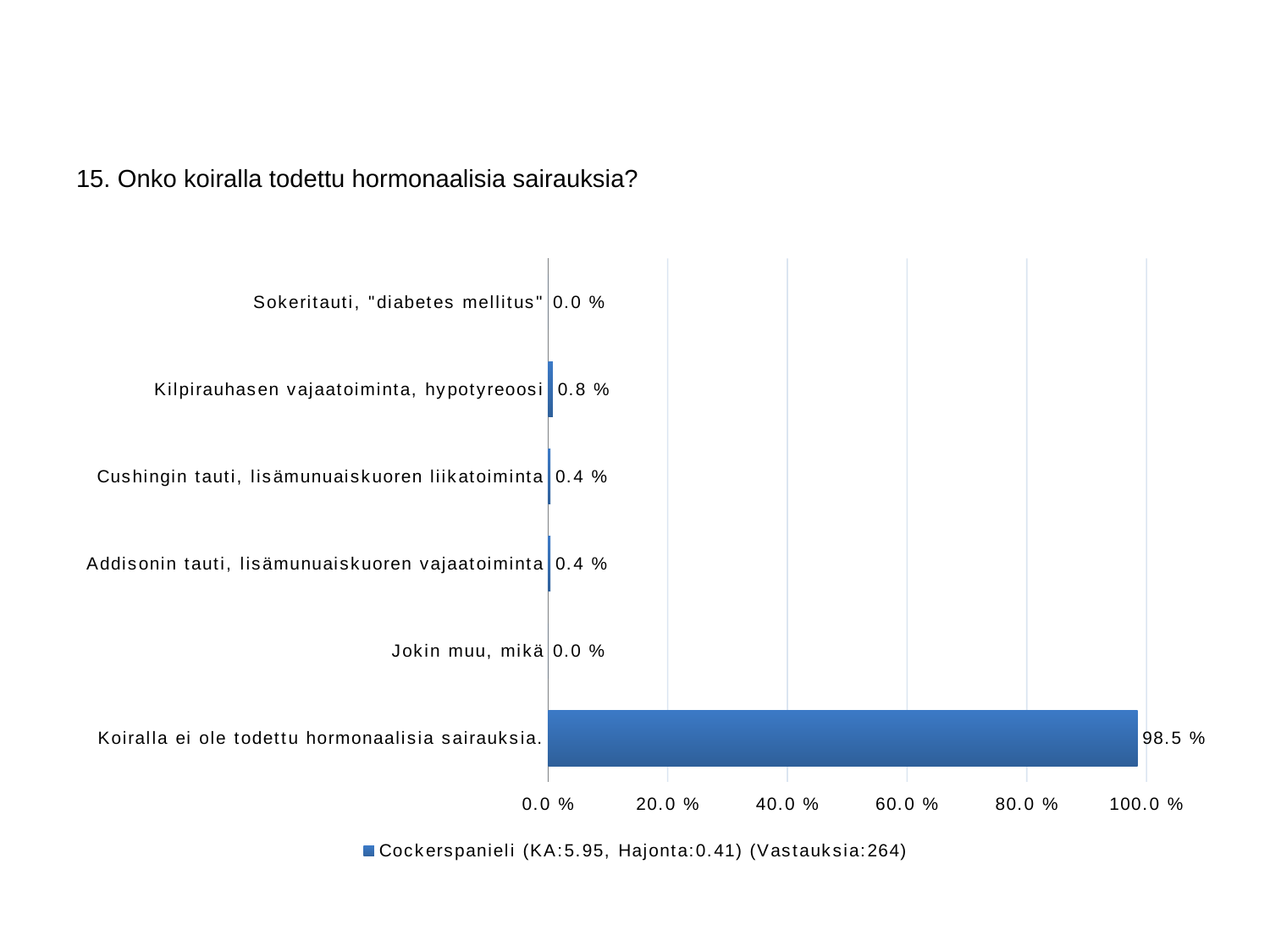
What is the value for "Cushingin tauti, lisämunuaiskuoren liikatoiminta"? 0.4 % Which is larger, the value for "Kilpirauhasen vajaatoiminta, hypotyreoosi" or the value for "Addisonin tauti, lisämunuaiskuoren vajaatoiminta"? Kilpirauhasen vajaatoiminta, hypotyreoosi How many categories are shown in the chart? 6 Which category has the highest value? Koiralla ei ole todettu hormonaalisia sairauksia. What is the value for "Sokeritauti, "diabetes mellitus""? 0.0 % What is the value for "Koiralla ei ole todettu hormonaalisia sairauksia."? 98.5 % How many series does the legend list? 1 Is the value for "Koiralla ei ole todettu hormonaalisia sairauksia." greater or less than 80.0 %? greater What is the value for "Kilpirauhasen vajaatoiminta, hypotyreoosi"? 0.8 % What kind of chart is shown on the slide? bar chart What is the difference between the values for "Koiralla ei ole todettu hormonaalisia sairauksia." and "Kilpirauhasen vajaatoiminta, hypotyreoosi"? 97.7 % What is the title of the chart? 15. Onko koiralla todettu hormonaalisia sairauksia?